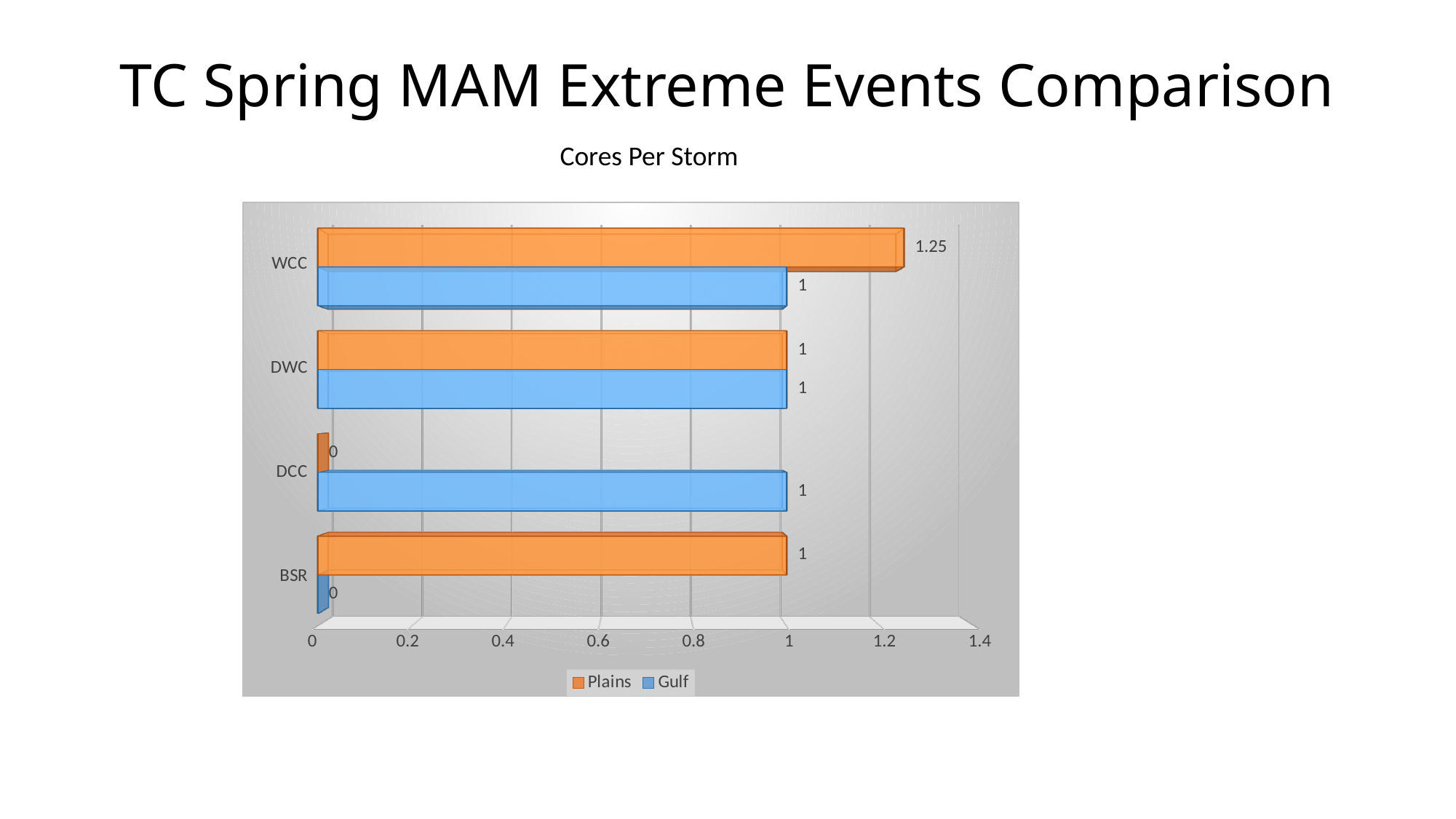
Is the Plains value for WCC greater or less than 1.2? greater How many categories are shown on the chart? 4 What type of chart is shown on the slide? Bar chart Which category has the highest Plains value? WCC What is the Plains value for WCC? 1.25 What is the Gulf value for BSR? 0 What is the difference between the Plains and Gulf values for WCC? 0.25 What is the Plains value for DCC? 0 For BSR, which series has the larger value, Plains or Gulf? Plains How many series does the legend list? 2 What is the Gulf value for DCC? 1 Which category has the lowest Gulf value? BSR